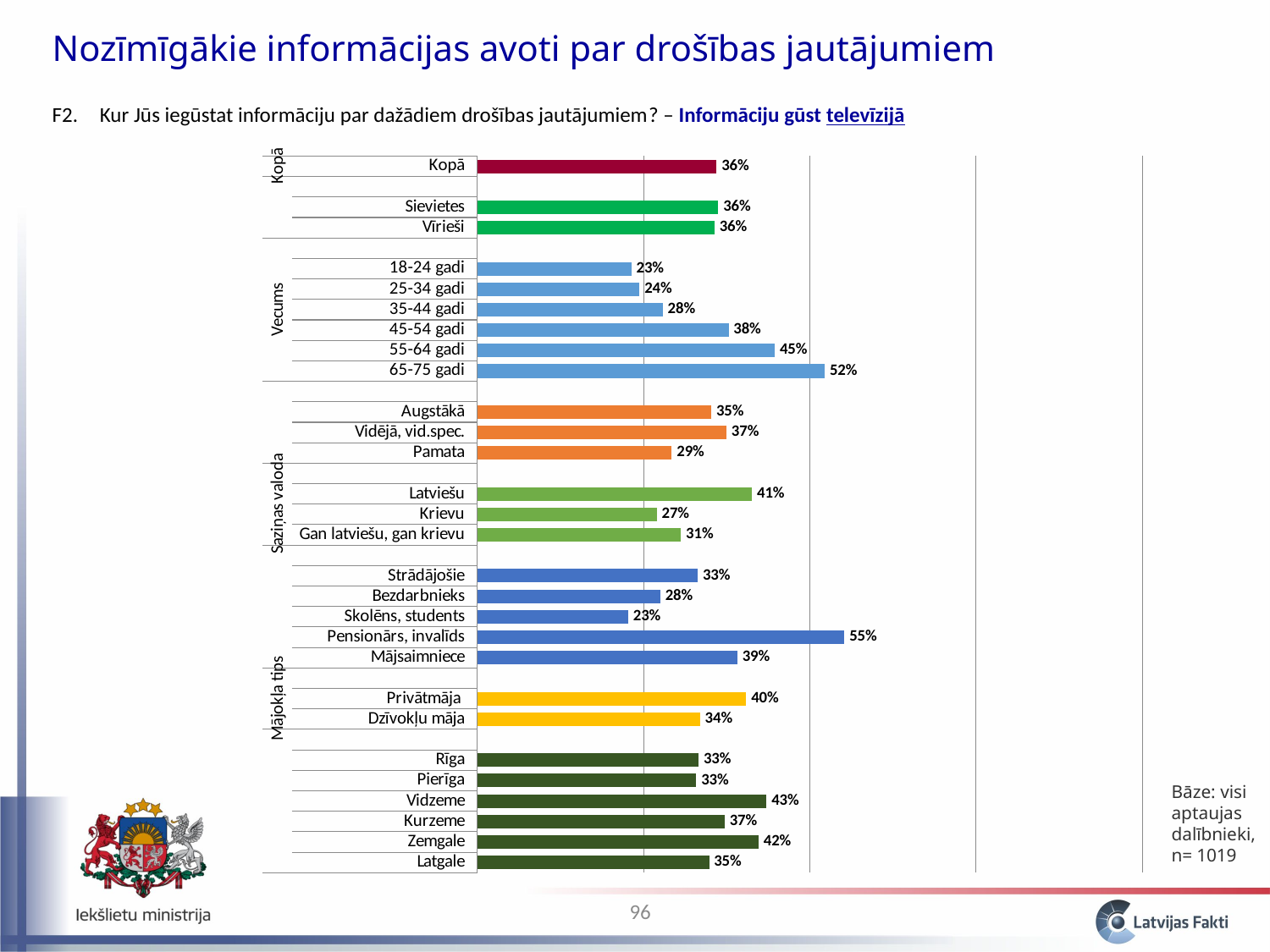
Which category has the highest value on the chart? Pensionārs, invalīds Do the values rise or fall as the age groups go from 18-24 gadi to 65-75 gadi? rise Which region has the highest value: Rīga, Vidzeme, Kurzeme, Zemgale or Latgale? Vidzeme Which age group (Vecums) has the lowest value? 18-24 gadi How many categories (bars) are plotted on the chart? 28 Which is larger, the value for Privātmāja or Dzīvokļu māja? Privātmāja What is the value for Pensionārs, invalīds? 55% What is the difference between the values for 65-75 gadi and 18-24 gadi? 29% What is the value for 65-75 gadi? 52% What is the value for Kopā? 36% What kind of chart is shown on the slide? bar chart What is the value for Krievu? 27%